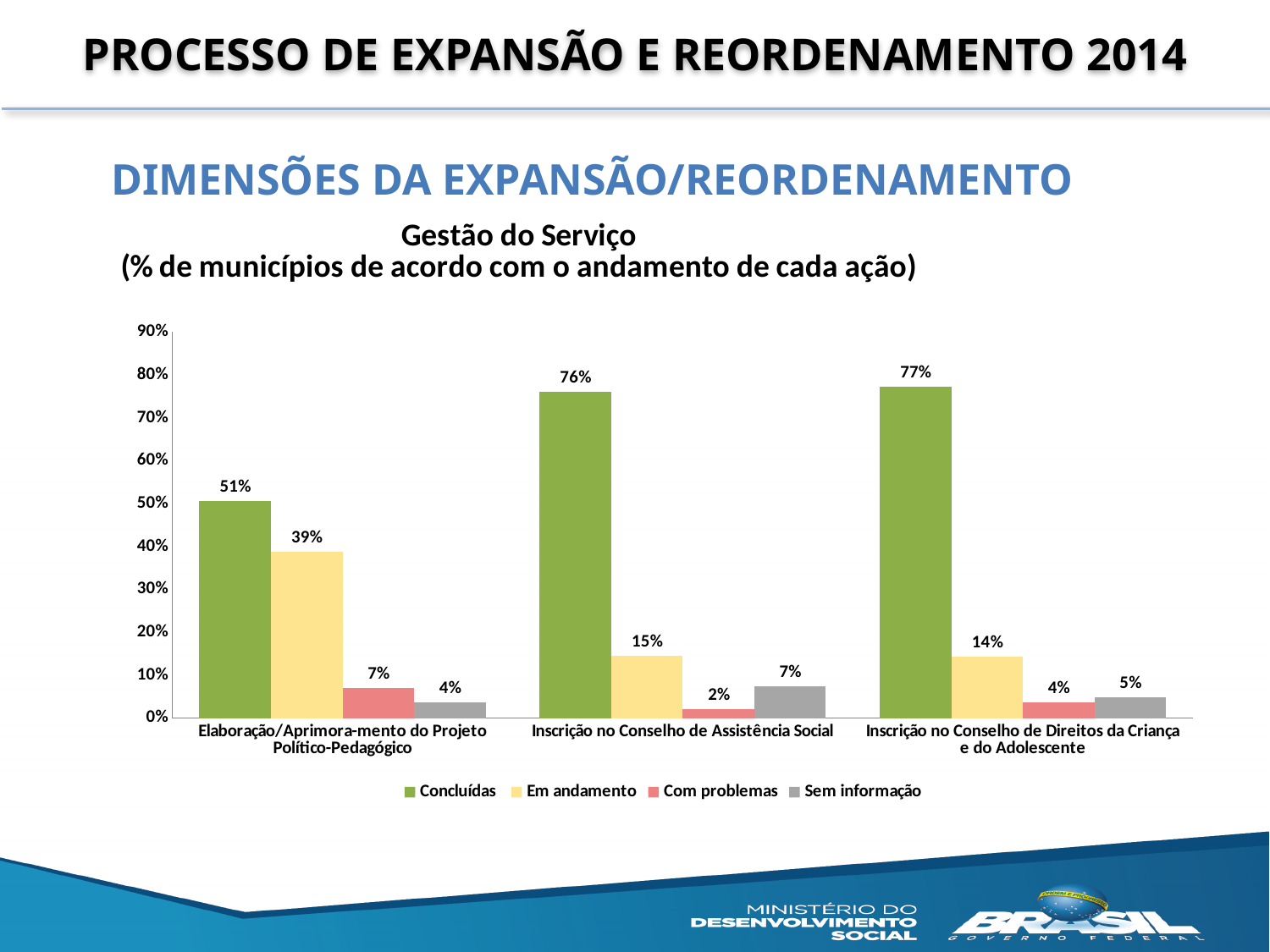
What is the value for Com problemas in the Inscrição no Conselho de Direitos da Criança e do Adolescente category? 4% What kind of chart is shown on the slide? Bar chart How many categories are shown on the x axis? 3 What is the value for Em andamento in the Elaboração/Aprimora-mento do Projeto Político-Pedagógico category? 39% What is the value for Concluídas in the Inscrição no Conselho de Assistência Social category? 76% What is the value for Sem informação in the Inscrição no Conselho de Assistência Social category? 7% Which category has the highest value for Concluídas? Inscrição no Conselho de Direitos da Criança e do Adolescente What is the difference between the Concluídas value and the Em andamento value in the Elaboração/Aprimora-mento do Projeto Político-Pedagógico category? 12% How many series does the legend list? 4 Which category has the lowest value for Com problemas? Inscrição no Conselho de Assistência Social What colour represents the Concluídas series in the legend? Green Which is larger: Em andamento for Inscrição no Conselho de Assistência Social or Em andamento for Inscrição no Conselho de Direitos da Criança e do Adolescente? Inscrição no Conselho de Assistência Social